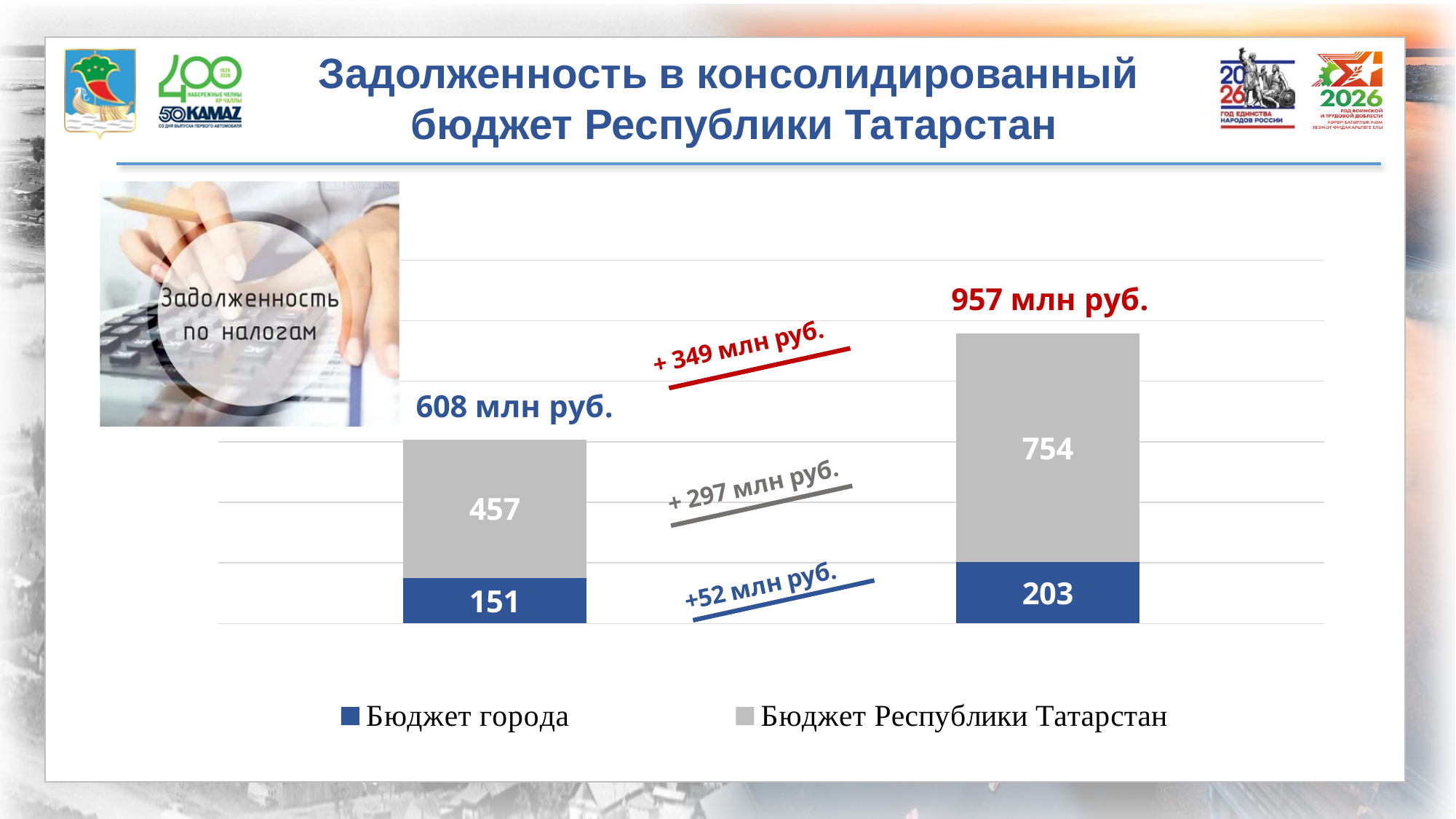
How many bars are plotted in the chart? 2 Which is larger: the 'Бюджет города' segment in the left bar or in the right bar? right bar What is the total of the left stacked bar as labelled on the slide? 608 млн руб. What is the value of the 'Бюджет Республики Татарстан' segment in the right bar? 754 How many series does the legend list? 2 What is the value of the 'Бюджет города' segment in the right bar? 203 What is the total of the right stacked bar as labelled on the slide? 957 млн руб. By how much does the 'Бюджет Республики Татарстан' segment in the right bar exceed the one in the left bar? 297 What kind of chart is shown on the slide? stacked bar chart Which series is shown in blue in the legend? Бюджет города What is the value of the 'Бюджет города' segment in the left bar? 151 What is the value of the 'Бюджет Республики Татарстан' segment in the left bar? 457